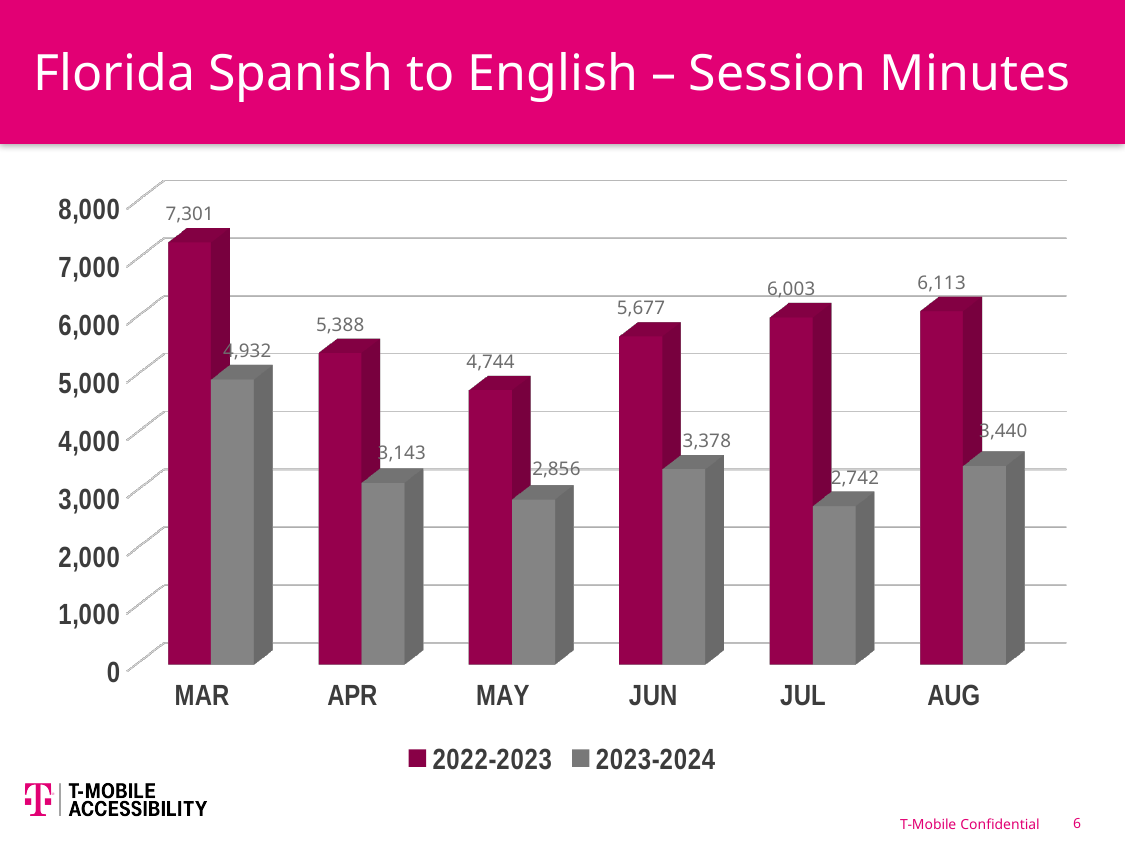
What is the title of the chart? Florida Spanish to English – Session Minutes How many months are shown on the x axis? 6 What is the 2023-2024 value for JUL? 2,742 How many series does the legend list? 2 What is the 2022-2023 value for MAR? 7,301 Which month has the highest 2022-2023 value? MAR What is the difference between the 2022-2023 and 2023-2024 values for MAY? 1,888 Is the 2022-2023 value for APR greater or less than 5,000? greater Which is larger, the 2023-2024 value for JUN or the 2023-2024 value for AUG? AUG Which month has the lowest 2023-2024 value? JUL What kind of chart is shown on the slide? bar chart What is the 2022-2023 value for AUG? 6,113